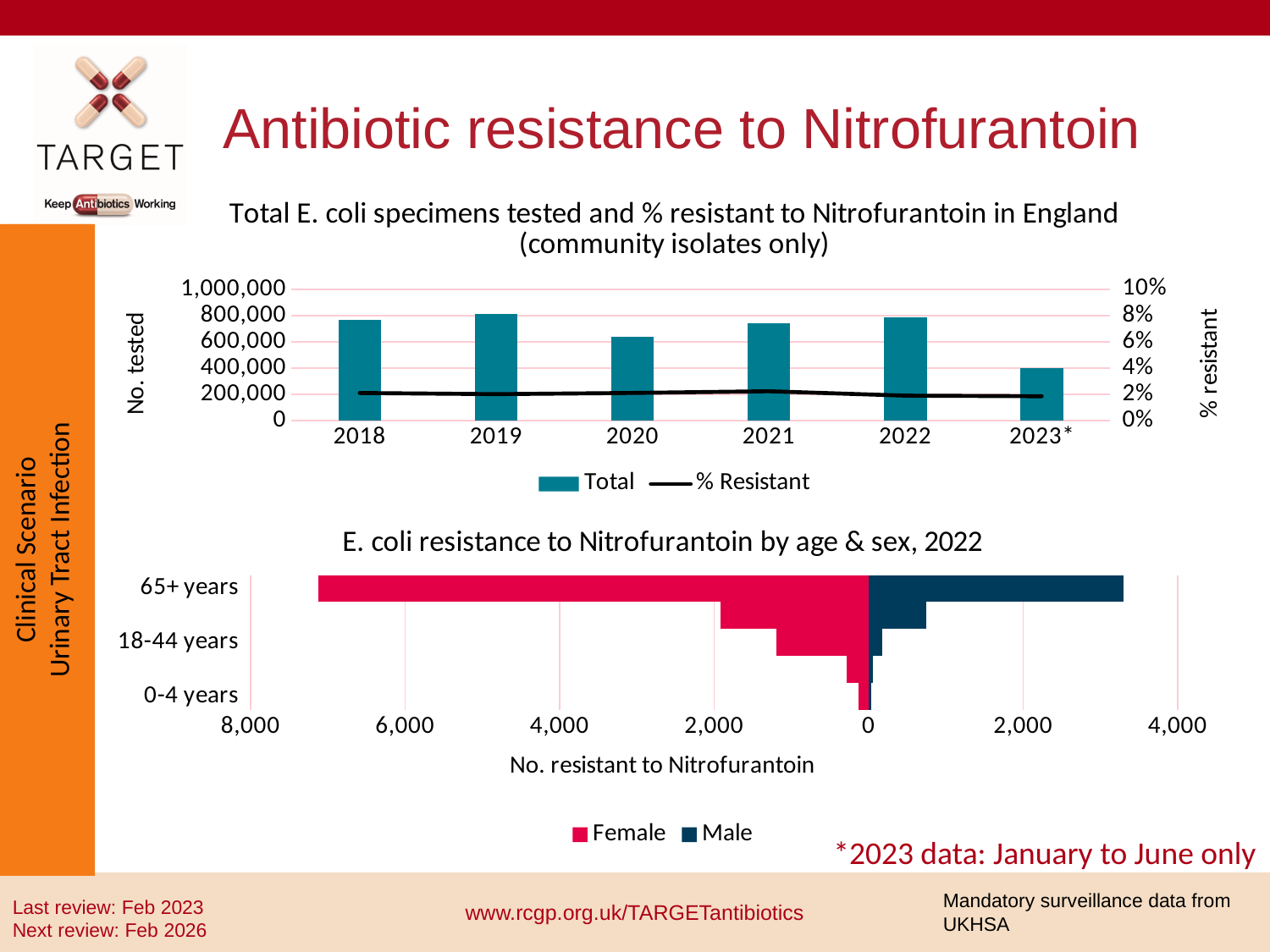
In the bottom chart, for 65+ years, which sex has more resistant isolates, Female or Male? Female How many years are shown on the x axis of the top chart? 6 In the top chart, which year had more specimens tested, 2020 or 2021? 2021 In the top chart, which year has the lowest number of E. coli specimens tested? 2023* In the bottom chart, which age group has the highest number of female resistant isolates? 65+ years In the bottom chart, is the number of female resistant isolates for 65+ years greater or less than 6,000? greater How many series does the legend of the top chart list? 2 What does the asterisk on 2023 in the top chart indicate? 2023 data: January to June only In the top chart, is the % resistant in 2021 greater or less than 4%? less In the top chart, is the number tested in 2023* greater or less than 600,000? less What type of chart is the bottom chart, 'E. coli resistance to Nitrofurantoin by age & sex, 2022'? bar chart